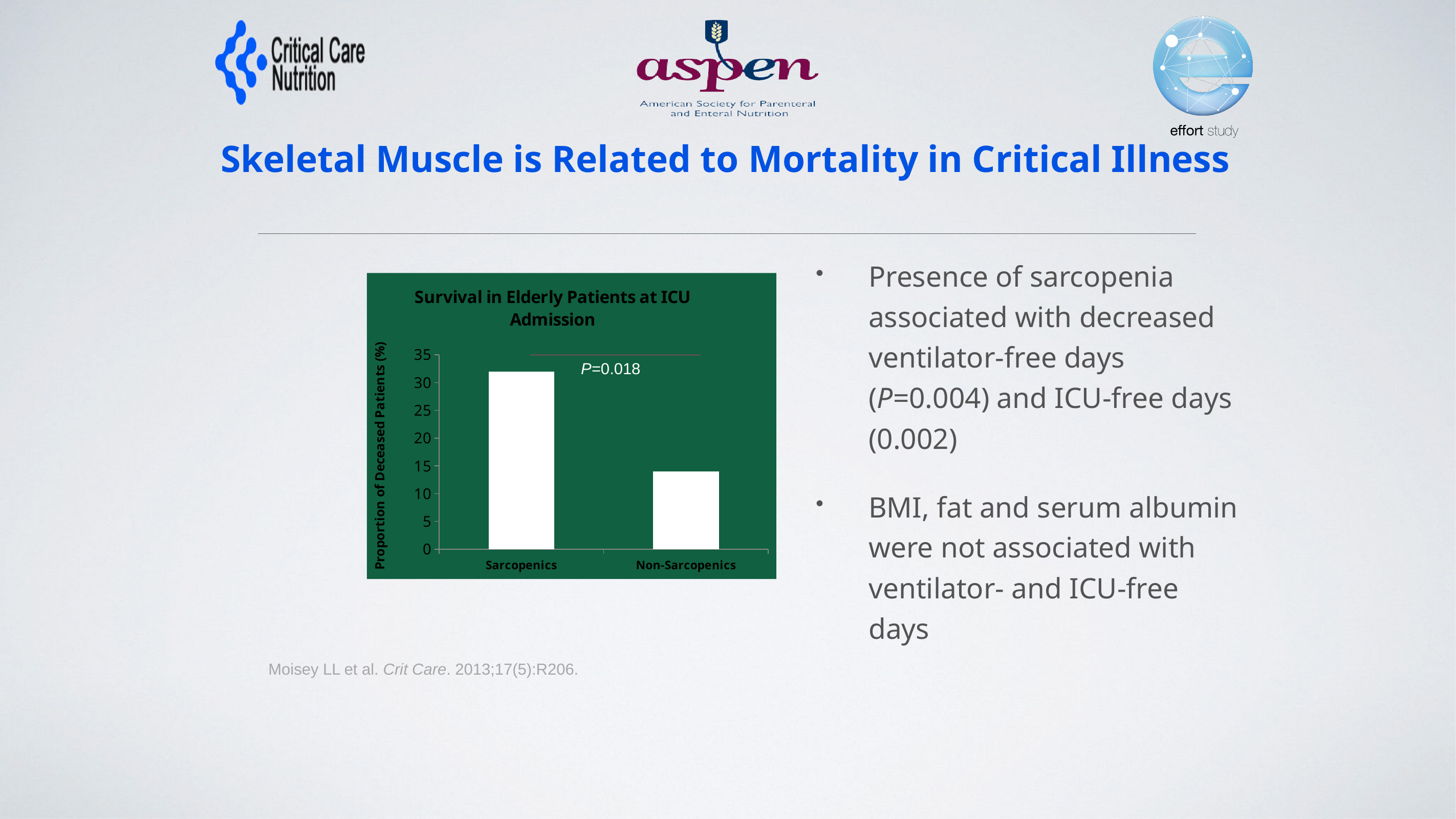
What is the title of the chart? Survival in Elderly Patients at ICU Admission Do the values rise or fall from Sarcopenics to Non-Sarcopenics along the x axis? fall What kind of chart is shown on the slide? bar chart Which is larger, the value for Sarcopenics or the value for Non-Sarcopenics? Sarcopenics How many categories are plotted in the chart? 2 What P value is printed on the chart? P=0.018 Which category has the lowest proportion of deceased patients? Non-Sarcopenics Is the value for Sarcopenics greater or less than 25? greater Which category has the highest proportion of deceased patients? Sarcopenics Is the value for Non-Sarcopenics greater or less than 10? greater Is the value for Non-Sarcopenics greater or less than 20? less